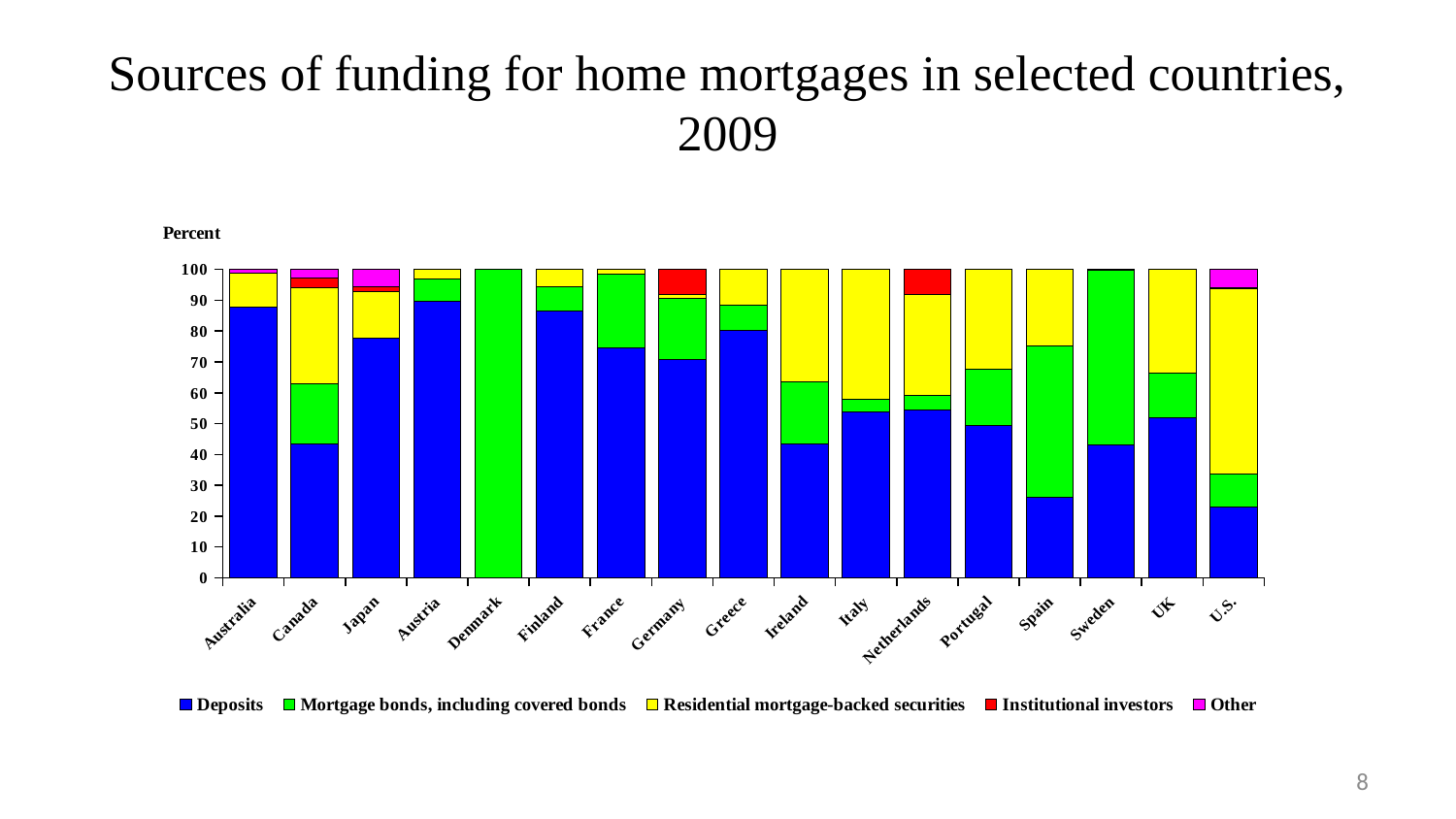
What is the title of the chart? Sources of funding for home mortgages in selected countries, 2009 What kind of chart is shown on the slide? Stacked bar chart What is the total height of the stacked bar for Canada? 100 Is the value for Deposits in the U.S. greater or less than 30? less How many series does the legend list? 5 Which country has the lowest value for Deposits? Denmark Which series is shown in blue in the legend? Deposits How many countries are shown on the x axis of the chart? 17 Which has the larger value for Deposits, Japan or Sweden? Japan Is the value for Deposits in Australia greater or less than 80? greater Is the value for Deposits in Spain greater or less than 30? less What is the value of Mortgage bonds, including covered bonds for Denmark? 100